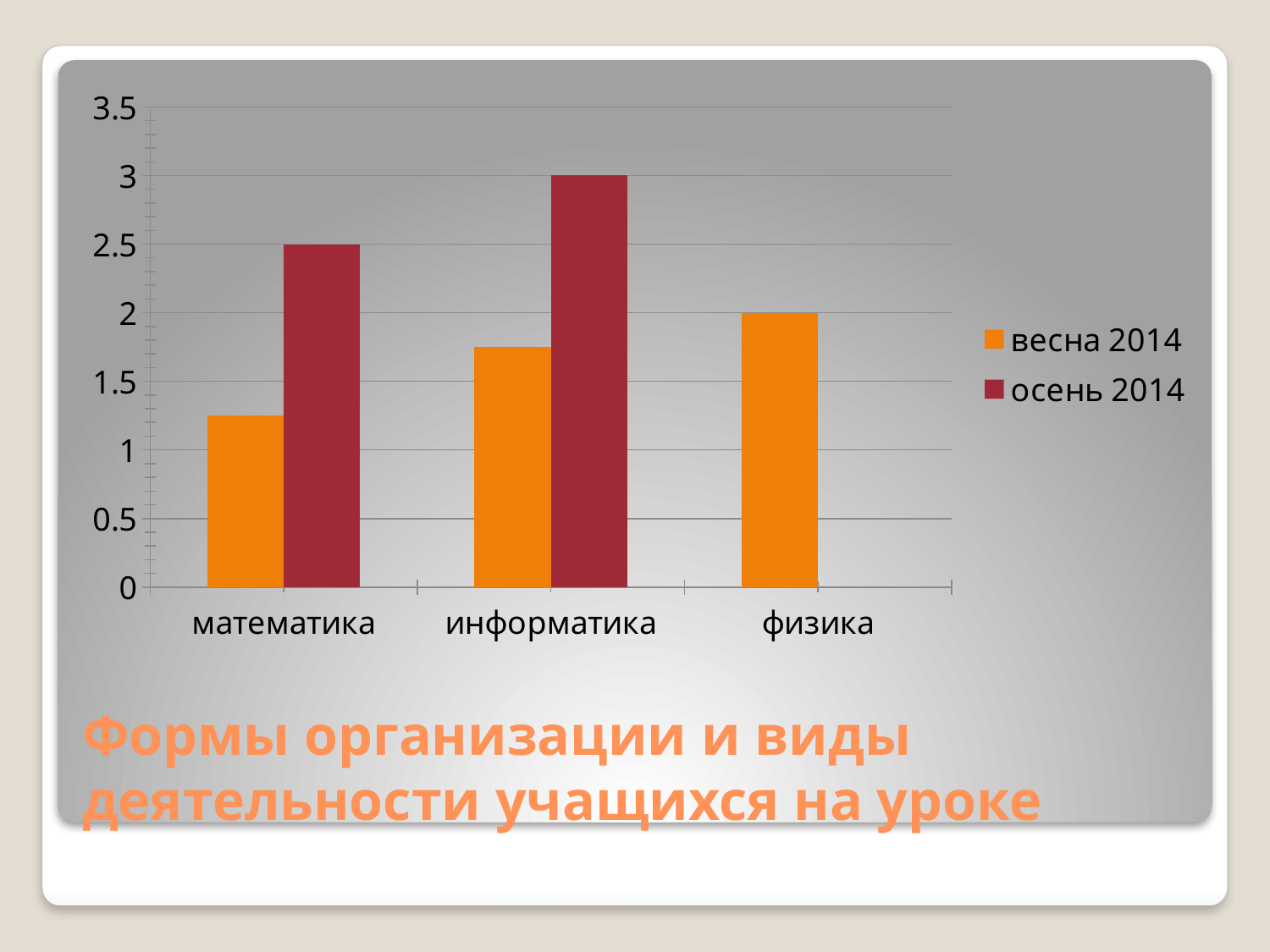
What is the value for весна 2014 in the физика category? 2 Is the value for весна 2014 in the информатика category greater or less than 1.5? greater What is the value for осень 2014 in the информатика category? 3 How many series does the legend list? 2 Which category has the highest value for осень 2014? информатика How many categories are shown on the x axis? 3 Is the value for весна 2014 in the математика category greater or less than 1.5? less Which series is shown in orange in the legend? весна 2014 What type of chart is shown on the slide? bar chart Which category has the lowest value for весна 2014? математика What is the difference between the осень 2014 values for информатика and математика? 0.5 What is the value for осень 2014 in the математика category? 2.5